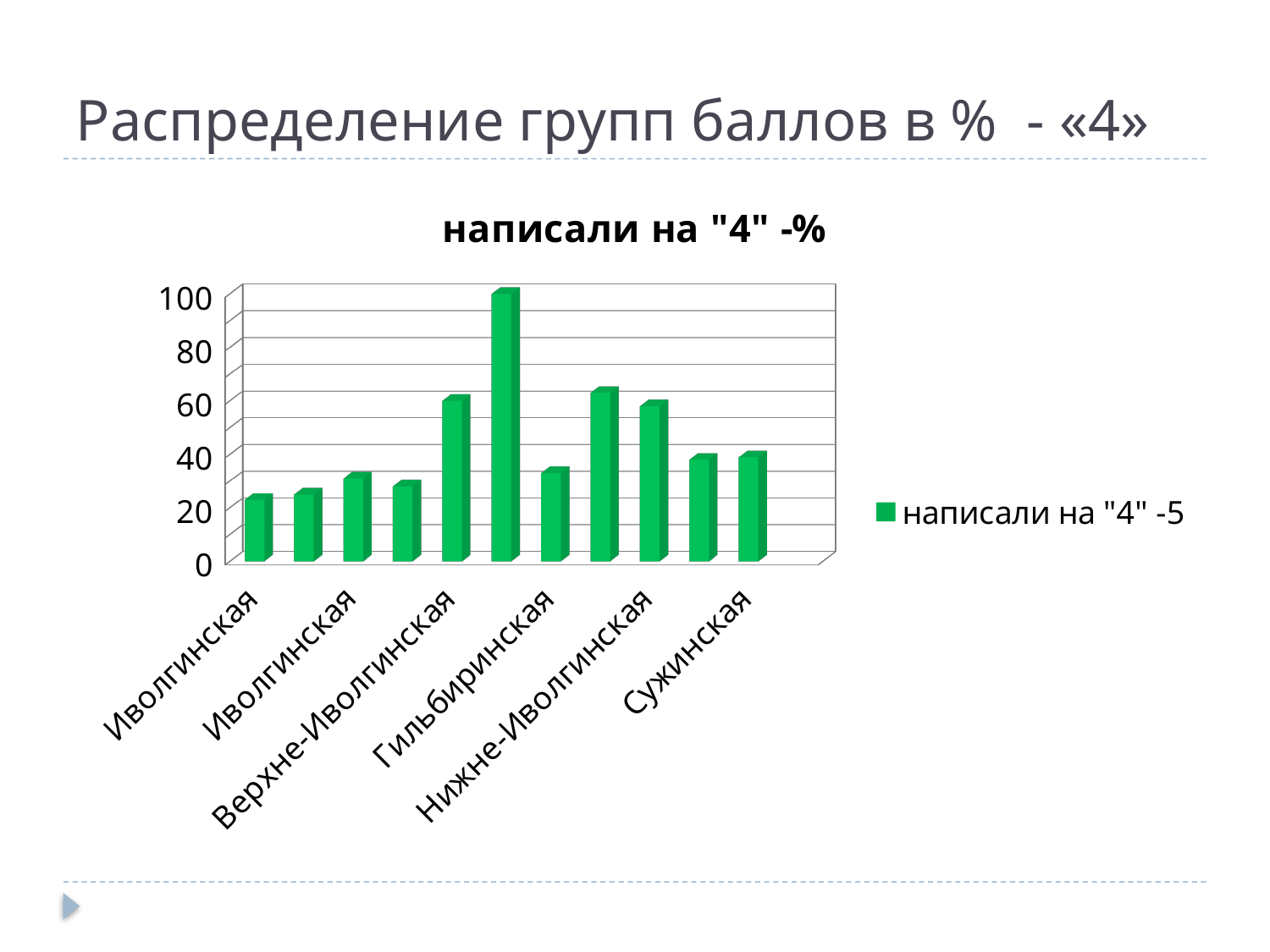
Is the value for Сужинская greater or less than 60? less What is the title of the chart? написали на "4" -% Which has the larger value, Верхне-Иволгинская or Сужинская? Верхне-Иволгинская How many bars are plotted in the chart? 11 Is the value for Гильбиринская greater or less than 40? less Is the value for Сужинская greater or less than 20? greater How many series does the legend list? 1 Which has the larger value, Нижне-Иволгинская or Гильбиринская? Нижне-Иволгинская What kind of chart is shown on the slide? bar chart What is the legend entry for the series? написали на "4" -5